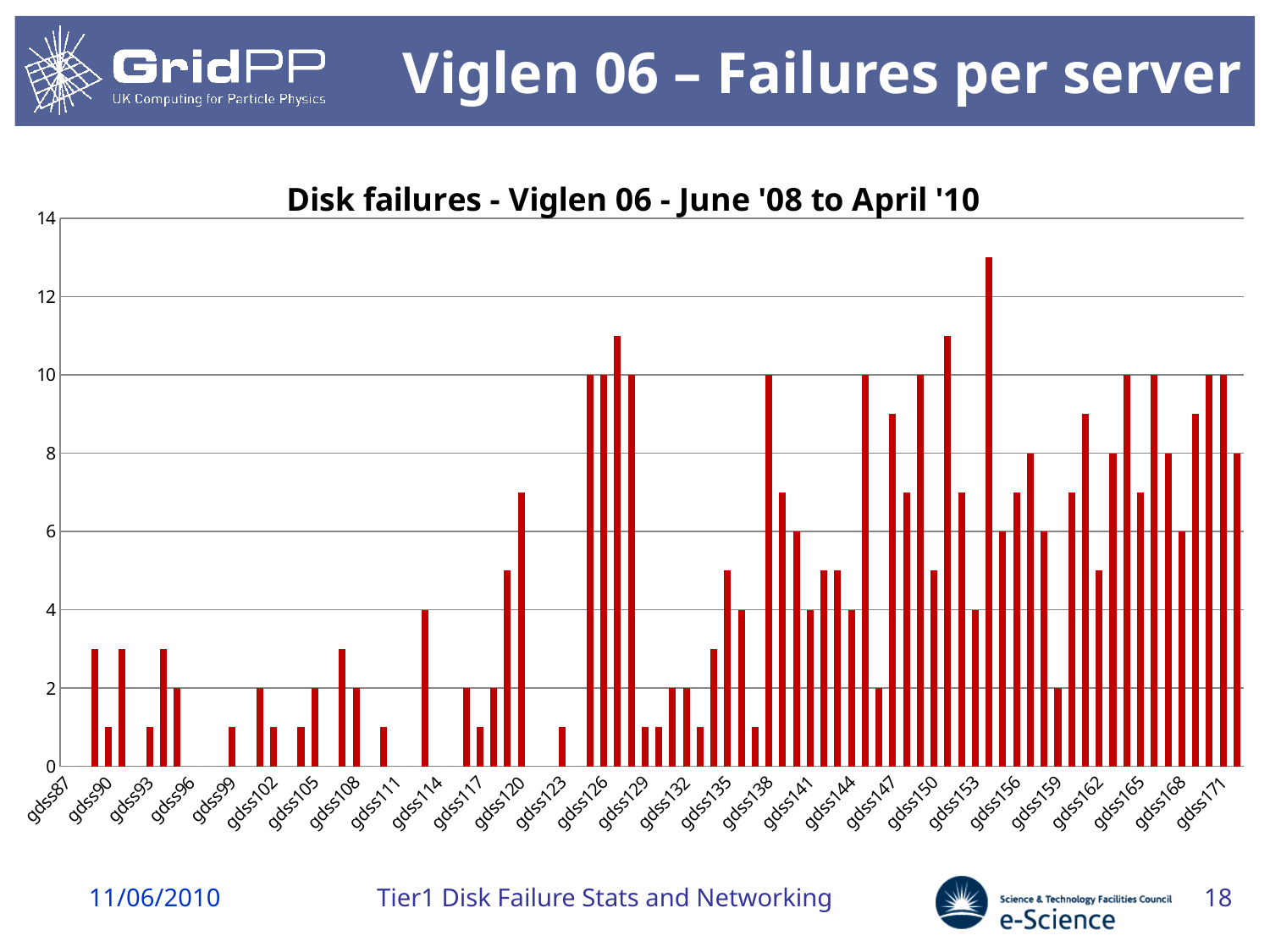
Is the value of the tallest bar in the chart greater or less than 14? less What is the highest value shown on the y axis? 14 Which server label appears last (rightmost) on the x axis? gdss171 Do the failure counts generally rise or fall moving from left to right along the x axis? rise What is the title of the chart? Disk failures - Viglen 06 - June '08 to April '10 Is the value of the tallest bar in the chart greater or less than 12? greater What kind of chart is shown on the slide? bar chart How many server labels are printed along the x axis? 29